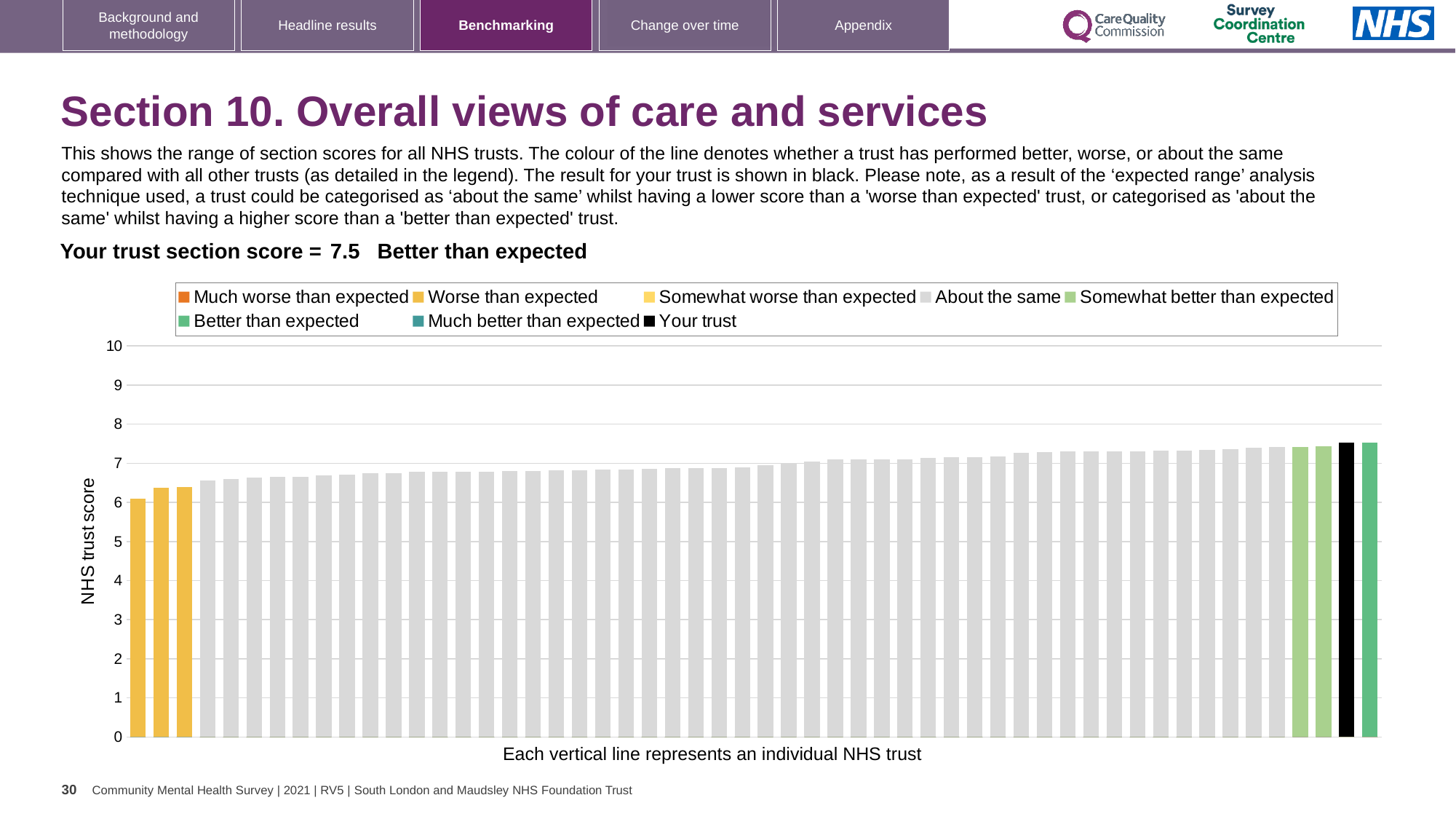
Which performance category is your trust placed in for this section? Better than expected What is the label on the vertical axis of the chart? NHS trust score What is the section score for your trust shown on the slide? 7.5 Is the value of the leftmost bar on the chart greater or less than 7? less What colour is used for the 'Your trust' bar in the chart? black What kind of chart is shown on the slide? bar chart Do the bar values rise or fall moving from left to right along the x axis? rise How many bars are coloured in the 'Worse than expected' yellow? 3 How many entries does the chart legend list? 8 Is the black 'Your trust' bar higher or lower than the leftmost bar? higher Is the value of the black 'Your trust' bar greater or less than 7? greater